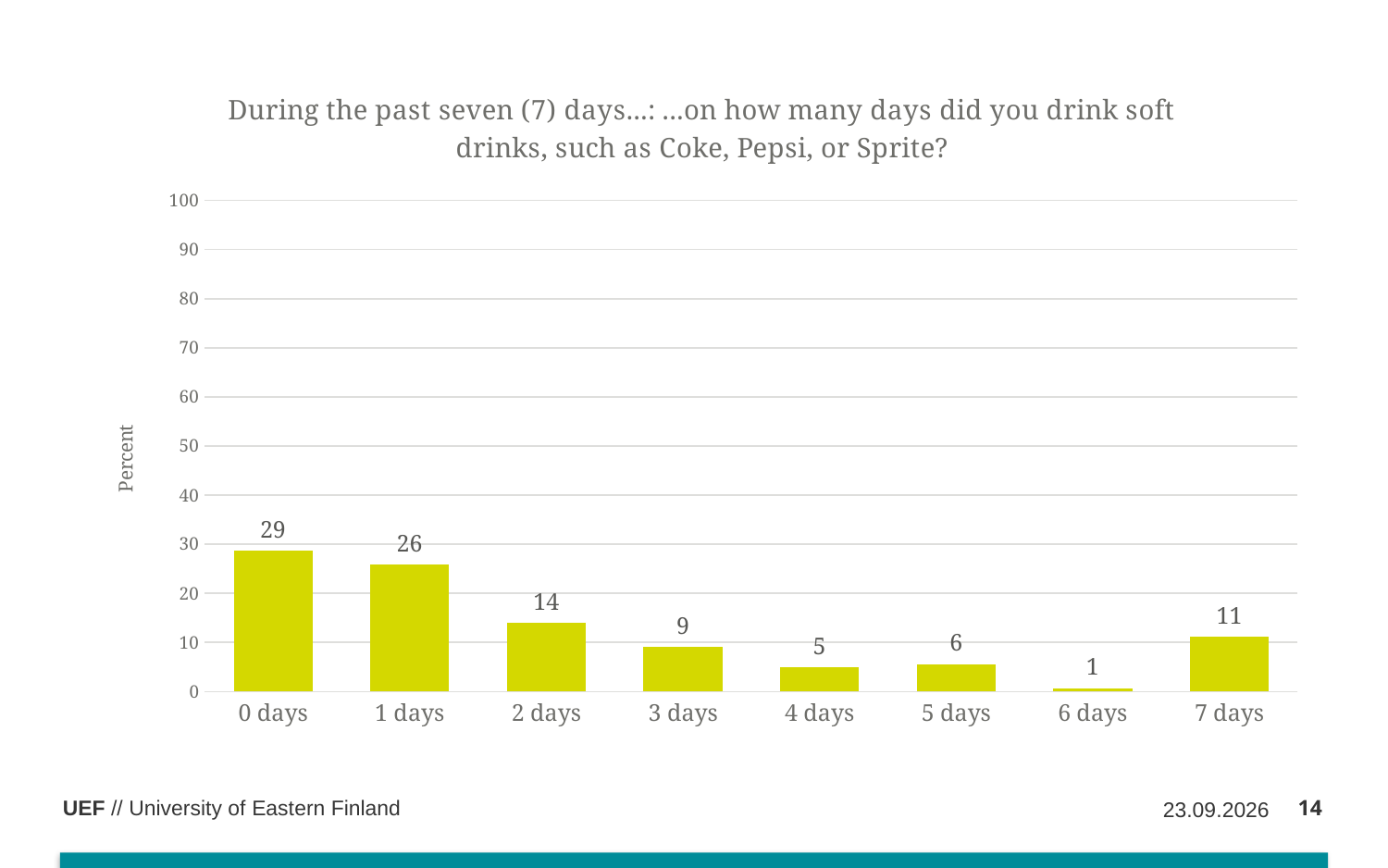
What is the difference between the values for 0 days and 1 days? 3 What is the difference between the values for 2 days and 3 days? 5 How many categories are shown on the x axis? 8 Which category has the highest value? 0 days What is the label of the y axis? Percent What is the value for 0 days? 29 What is the value for 7 days? 11 Which category has the lowest value? 6 days What kind of chart is this? bar chart What is the value for 2 days? 14 Is the value for 3 days greater or less than 10? less Which is larger, the value for 4 days or the value for 5 days? 5 days